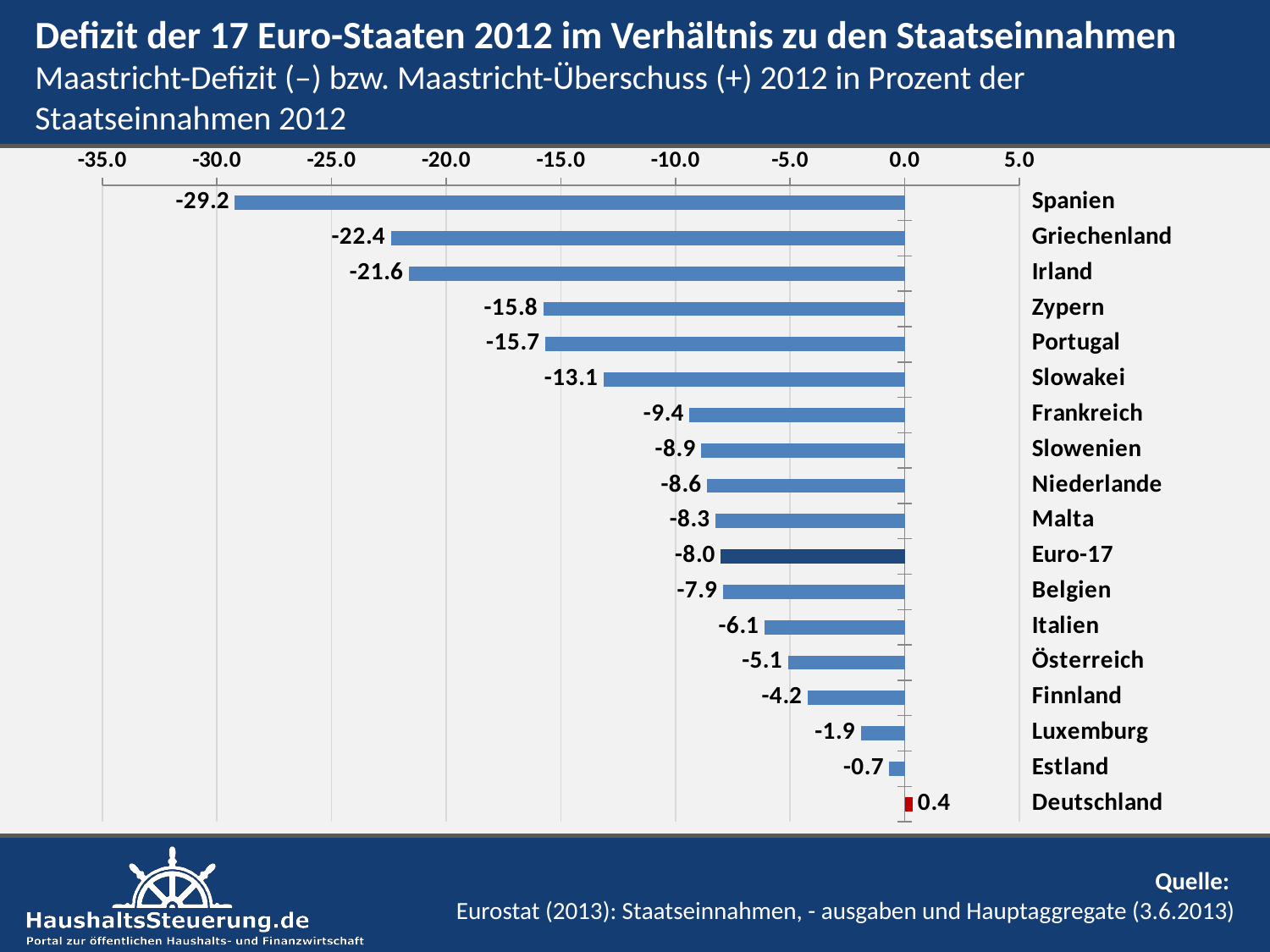
What is the value shown for Deutschland? 0.4 How many bars are shown in the chart? 18 What is the value shown for Slowakei? -13.1 Which bar is shown in red? Deutschland Which category has the lowest value? Spanien What is the value shown for Euro-17? -8.0 What kind of chart is shown on the slide? Bar chart What is the value shown for Spanien? -29.2 What is the difference between the values for Deutschland and Estland? 1.1 What is the difference between the values for Spanien and Griechenland? 6.8 Which category has the highest value? Deutschland Which has the larger value, Irland or Zypern? Zypern